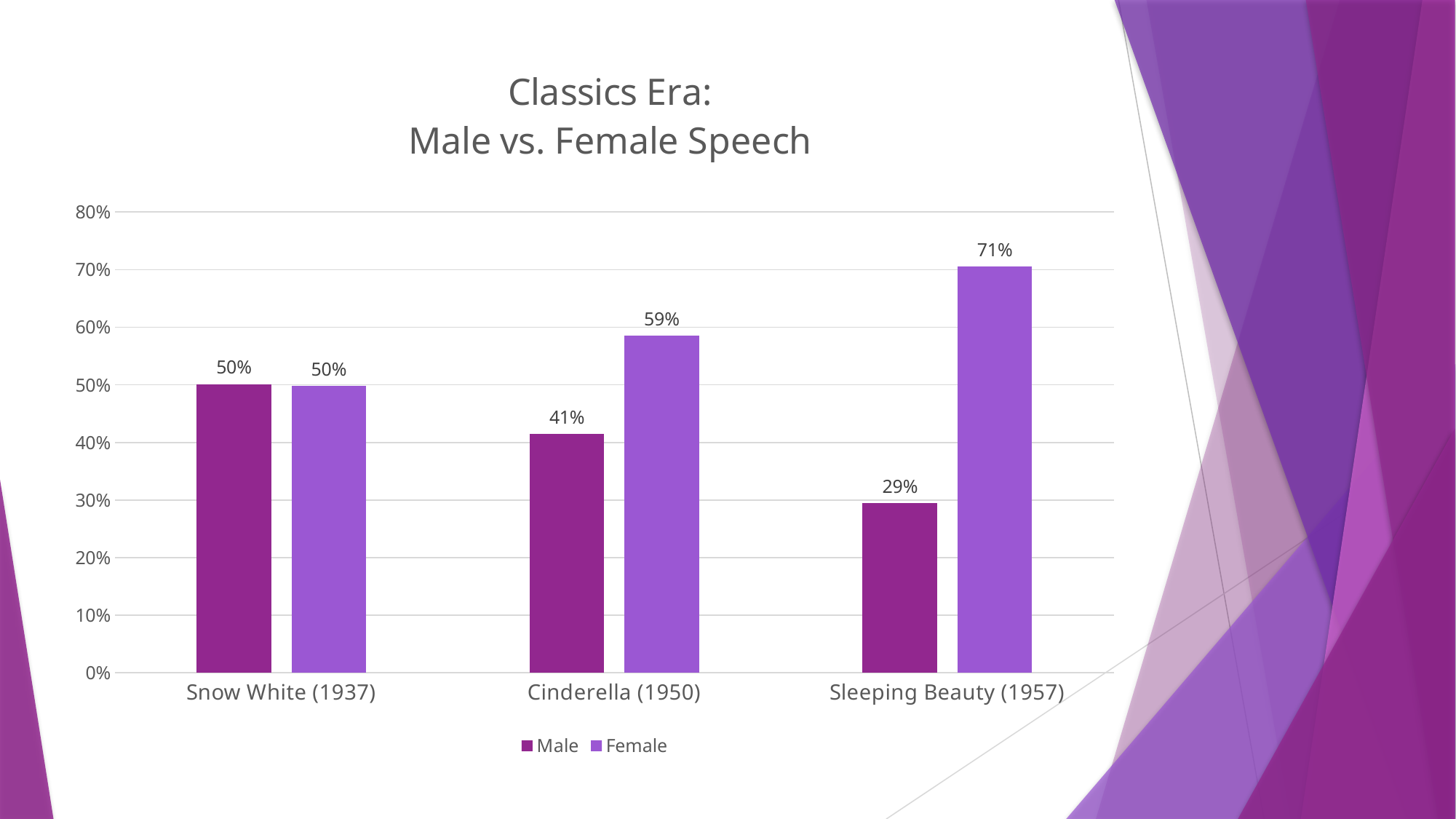
Which film has the lowest Male value? Sleeping Beauty (1957) What kind of chart is shown on the slide? Bar chart What is the Female value for Snow White (1937)? 50% How many series does the legend list? 2 Which is larger for Sleeping Beauty (1957), the Male value or the Female value? Female Which film has the highest Female value? Sleeping Beauty (1957) What is the Female value for Sleeping Beauty (1957)? 71% What is the difference between the Female and Male values for Cinderella (1950)? 18% Do the Male values rise or fall from Snow White (1937) to Sleeping Beauty (1957)? Fall What is the Male value for Sleeping Beauty (1957)? 29% How many films are shown on the x axis? 3 What is the Male value for Cinderella (1950)? 41%